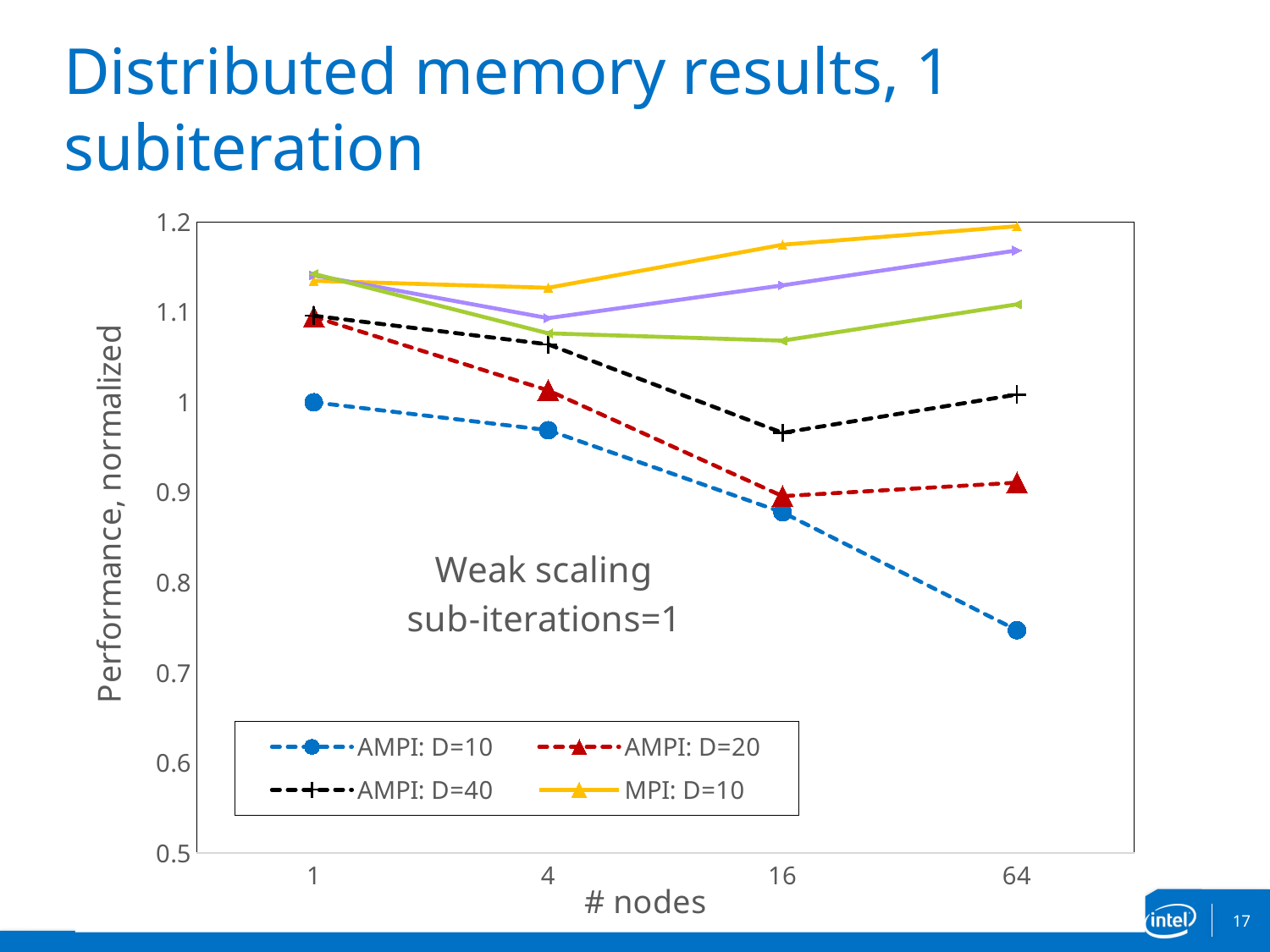
At 64 nodes, which is larger: MPI: D=10 or AMPI: D=10? MPI: D=10 What is the value of AMPI: D=10 at 1 node? 1 Is the value for AMPI: D=40 at 16 nodes greater or less than 1? less How many series does the legend list? 4 Which legend series has the lowest value at 64 nodes? AMPI: D=10 What kind of chart is shown on the slide? line chart Is the value for MPI: D=10 at 64 nodes greater or less than 1.1? greater Does the AMPI: D=10 series rise or fall as the number of nodes increases? fall How many node counts are shown on the x axis? 4 Which legend series has the highest value at 64 nodes? MPI: D=10 Is the value for AMPI: D=10 at 64 nodes greater or less than 0.8? less